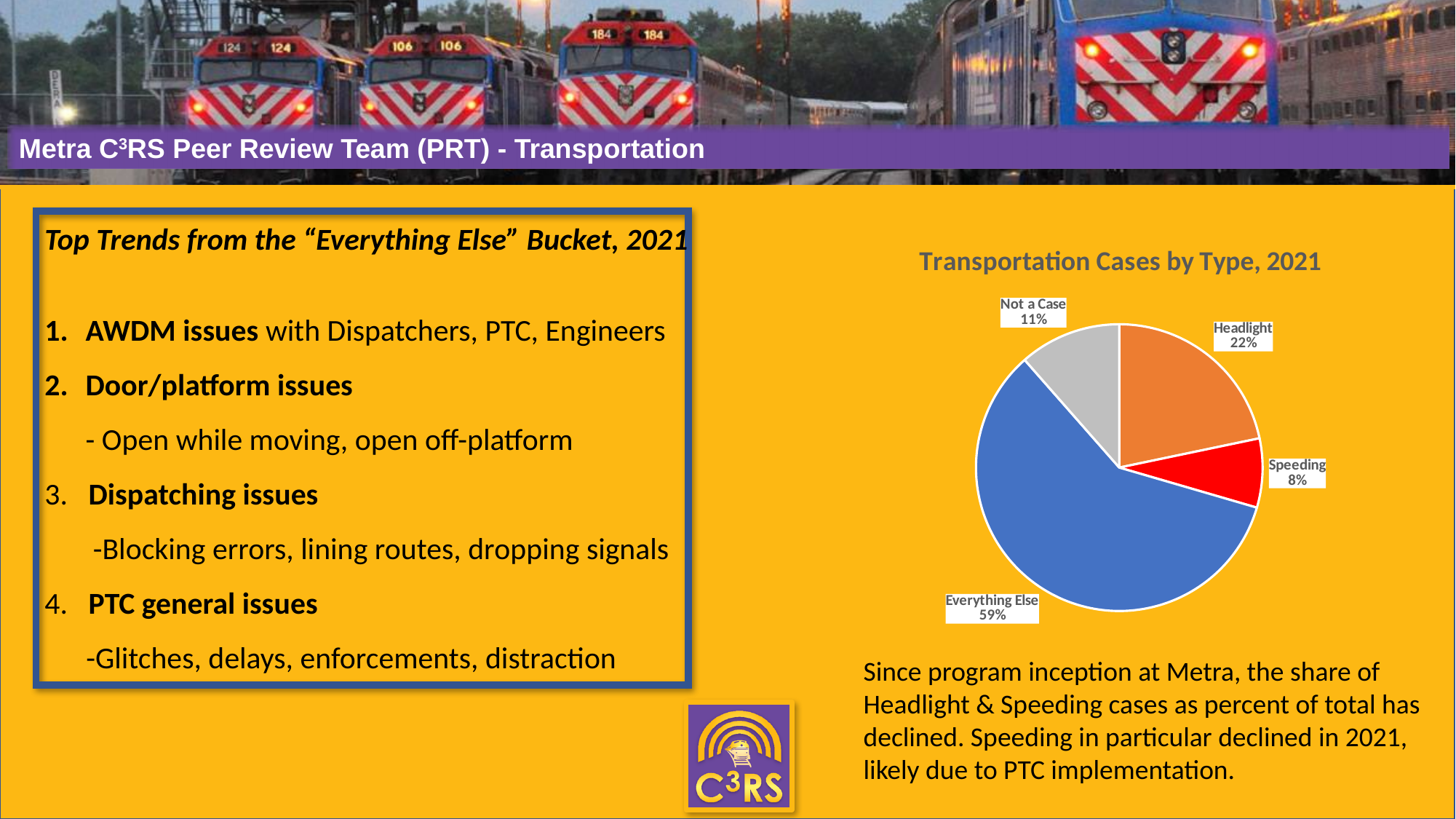
What is the title of the chart? Transportation Cases by Type, 2021 Which category has the smallest share of the pie? Speeding How many categories are shown in the pie chart? 4 What share of transportation cases is Headlight? 22% What share of transportation cases is Speeding? 8% Which is larger, the share for Not a Case or the share for Speeding? Not a Case Which category has the largest share of the pie? Everything Else What share of transportation cases is Everything Else? 59% What is the difference in percentage points between Headlight and Speeding? 14 What type of chart is shown on the slide? pie chart What colour is the Everything Else slice? blue